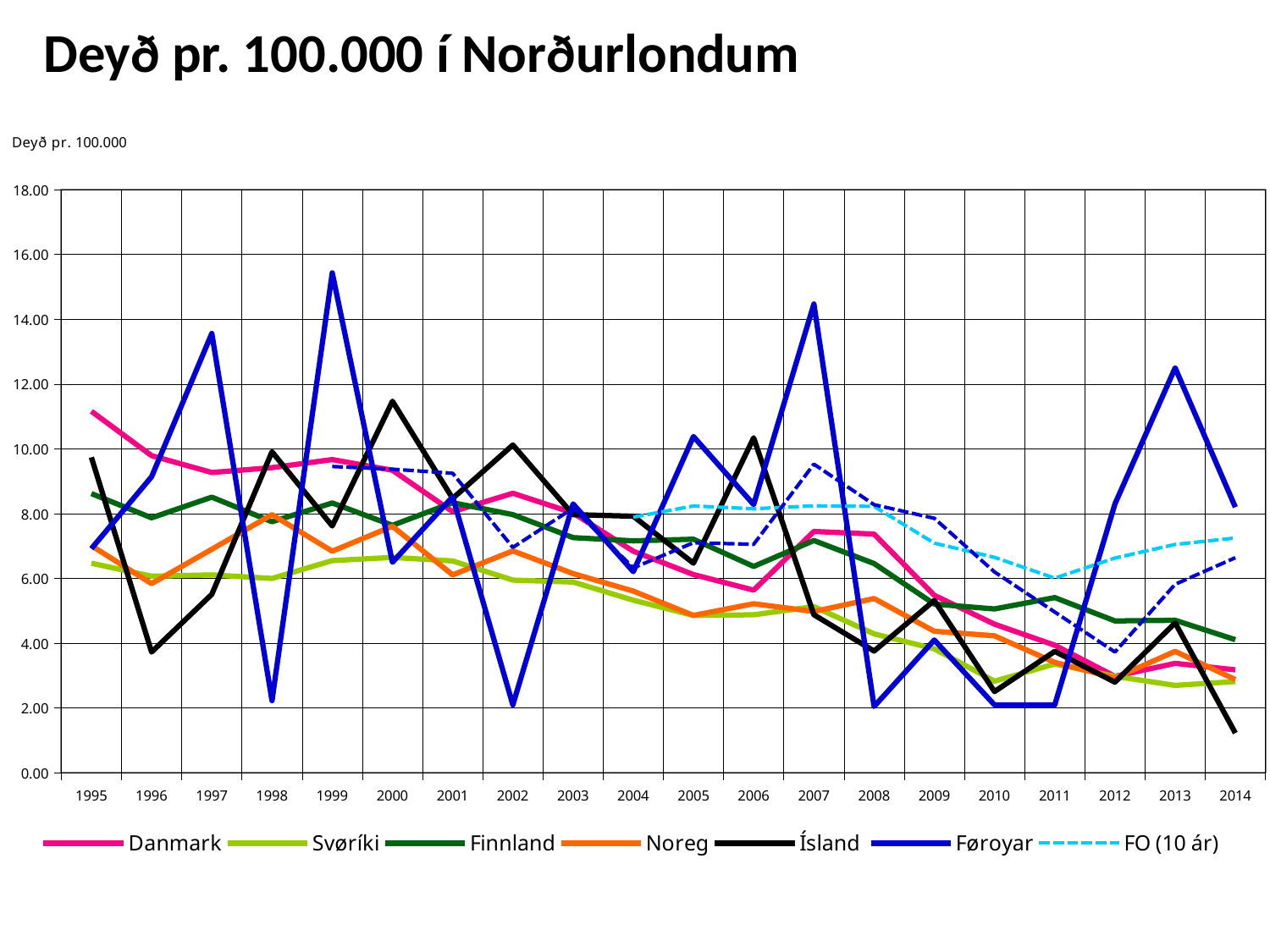
How many years are shown along the x axis? 20 Is the value for Danmark in 1995 greater or less than 10.00? greater Which series is drawn with a dashed line? FO (10 ár) In 2000, which is larger, the value for Ísland or the value for Noreg? Ísland How many series does the legend list? 7 Is the value for Føroyar in 1999 greater or less than 14.00? greater Is the value for Ísland in 2014 greater or less than 2.00? less Which series reaches the highest value anywhere on the chart? Føroyar Does the Danmark line generally rise or fall from 1995 to 2014? fall In which year does Føroyar reach its highest value? 1999 What kind of chart is shown on the slide? line chart